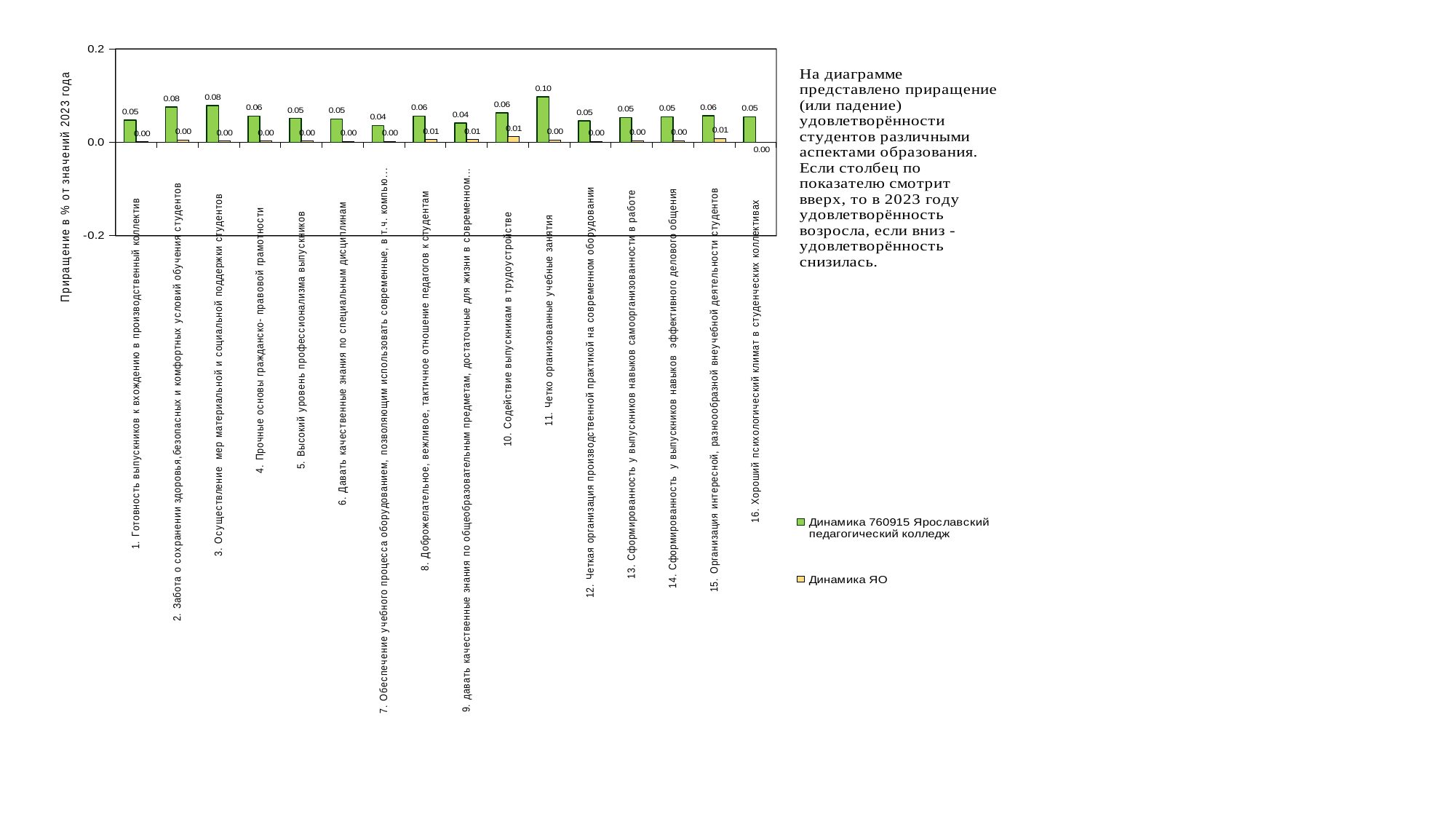
Which category has the highest value for the series 'Динамика 760915 Ярославский педагогический колледж'? 11. Четко организованные учебные занятия What is the value of the series 'Динамика ЯО' for category '10. Содействие выпускникам в трудоустройстве'? 0.01 How many categories are plotted on the x axis? 16 What is the difference between the 'Динамика 760915 Ярославский педагогический колледж' values for category '3. Осуществление мер материальной и социальной поддержки студентов' and category '4. Прочные основы гражданско-правовой грамотности'? 0.02 What is the label of the vertical axis? Приращение в % от значений 2023 года What is the value of the series 'Динамика ЯО' for category '1. Готовность выпускников к вхождению в производственный коллектив'? 0.00 What is the difference between the 'Динамика 760915 Ярославский педагогический колледж' value and the 'Динамика ЯО' value for category '11. Четко организованные учебные занятия'? 0.10 What is the value of the series 'Динамика 760915 Ярославский педагогический колледж' for category '11. Четко организованные учебные занятия'? 0.10 What is the value of the series 'Динамика 760915 Ярославский педагогический колледж' for category '2. Забота о сохранении здоровья, безопасных и комфортных условий обучения студентов'? 0.08 For category '15. Организация интересной, разнообразной внеучебной деятельности студентов', which series has the larger value: 'Динамика 760915 Ярославский педагогический колледж' or 'Динамика ЯО'? Динамика 760915 Ярославский педагогический колледж What type of chart is shown on the slide? bar chart How many series does the legend list? 2